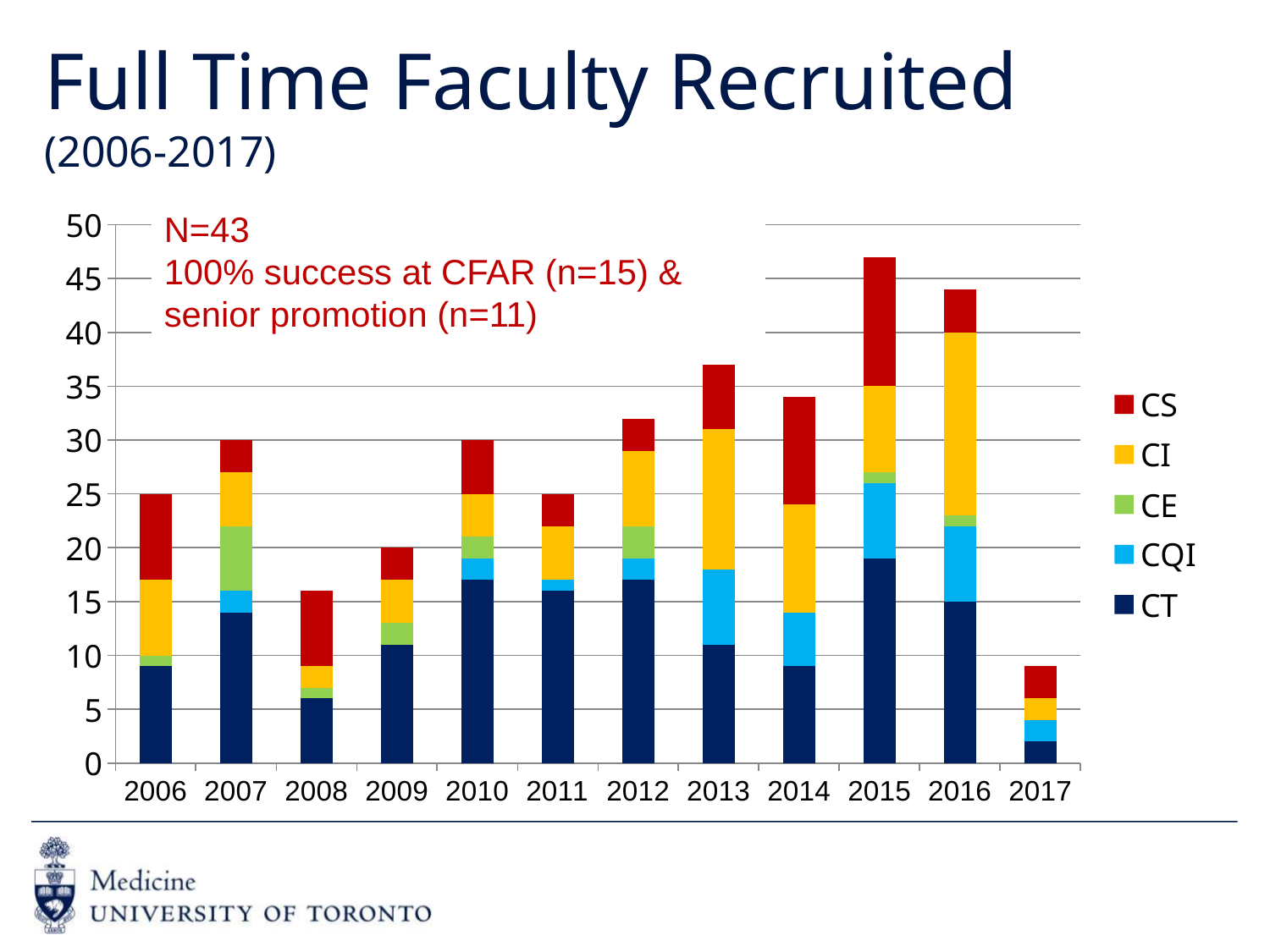
Is the total for 2013 greater or less than 35? greater How many series does the chart's legend list? 5 Do the bar totals rise or fall from 2008 to 2010? rise Which year has the larger total, 2012 or 2011? 2012 Is the total for 2015 greater or less than 45? greater Is the total for 2016 greater or less than 45? less Which series is shown at the bottom of each stacked bar, in dark blue? CT Which year has the shortest stacked bar? 2017 How many years are shown along the x axis of the chart? 12 What kind of chart is shown on the slide? stacked bar chart Which year has the tallest stacked bar? 2015